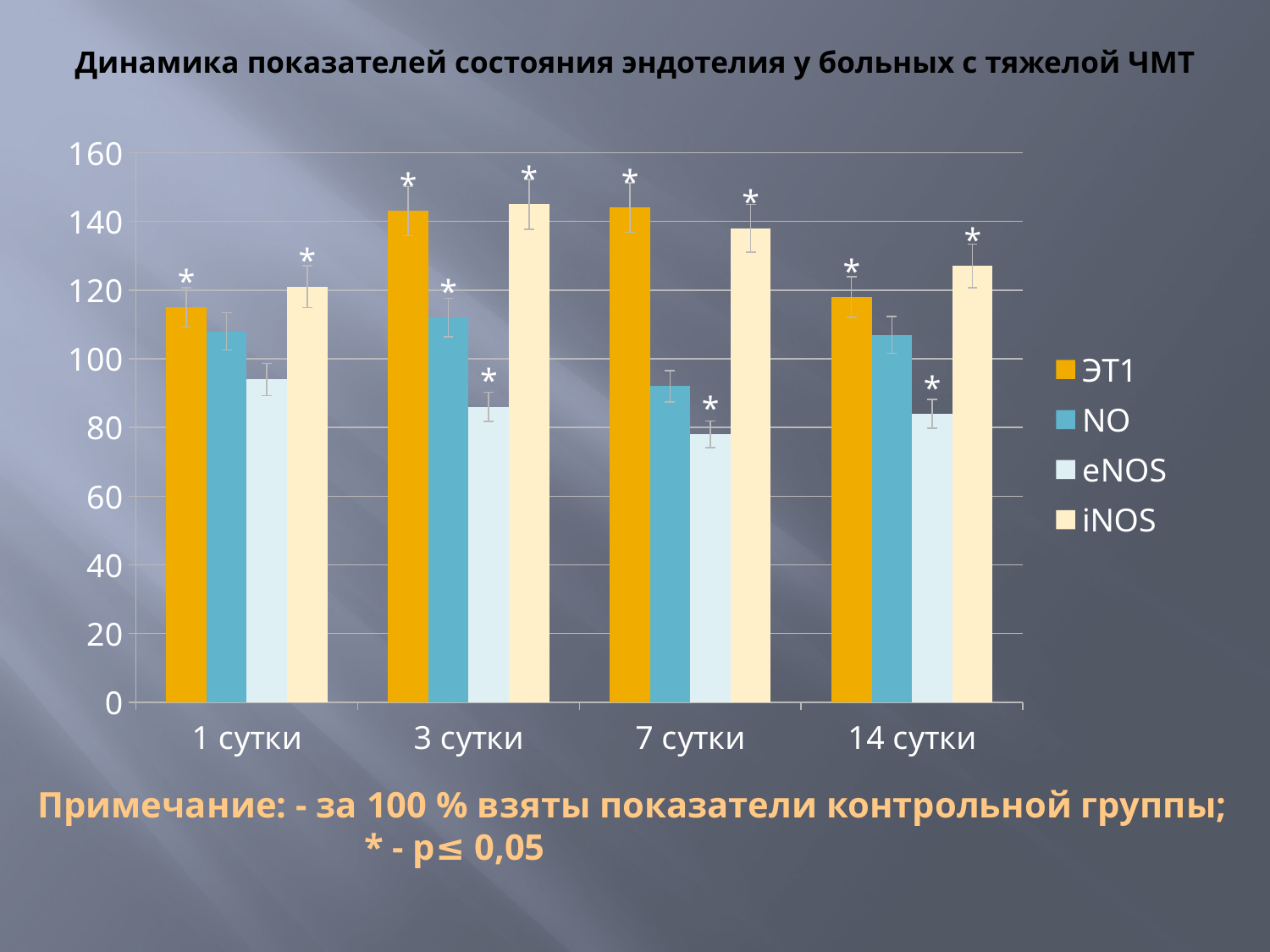
How many time-point categories are shown on the x axis? 4 What kind of chart is shown on the slide? bar chart Is the value for iNOS at 14 сутки greater or less than 140? less At 7 сутки, which is larger: ЭТ1 or NO? ЭТ1 At which time point is the eNOS value lowest? 7 сутки Is the value for NO at 1 сутки greater or less than 100? greater How many series does the legend list? 4 Which series has the lowest bar at 14 сутки? eNOS Is the value for ЭТ1 at 3 сутки greater or less than 120? greater Which series is shown in orange in the legend? ЭТ1 Does the eNOS value rise or fall from 1 сутки to 7 сутки? fall